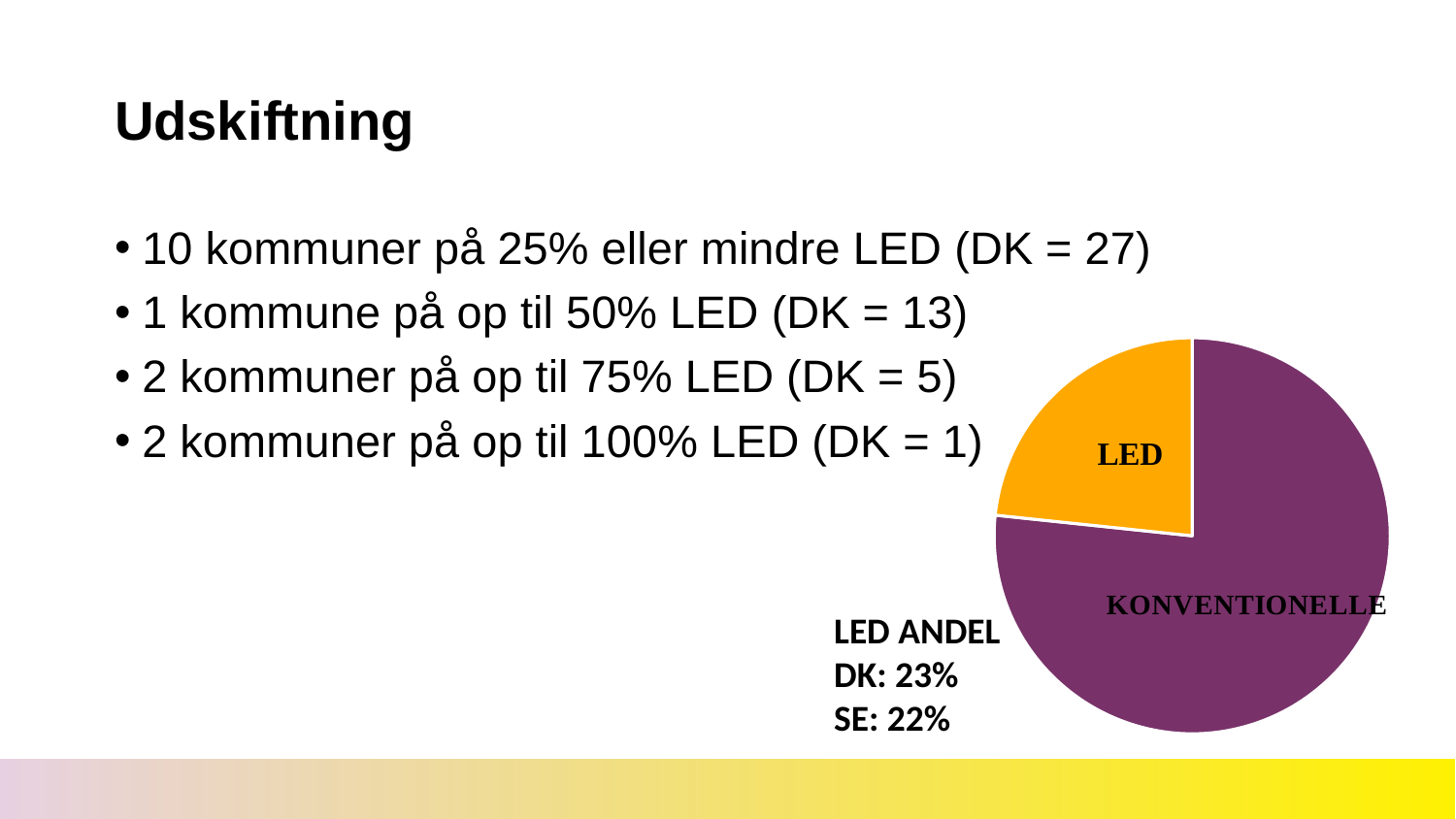
What colour is the LED slice in the pie chart? orange What kind of chart is shown on the slide? pie chart How many slices does the pie chart have? 2 Which slice of the pie chart is the largest? KONVENTIONELLE Which slice of the pie chart is coloured purple? KONVENTIONELLE Which slice is larger in the pie chart, LED or KONVENTIONELLE? KONVENTIONELLE Which slice of the pie chart is the smallest? LED